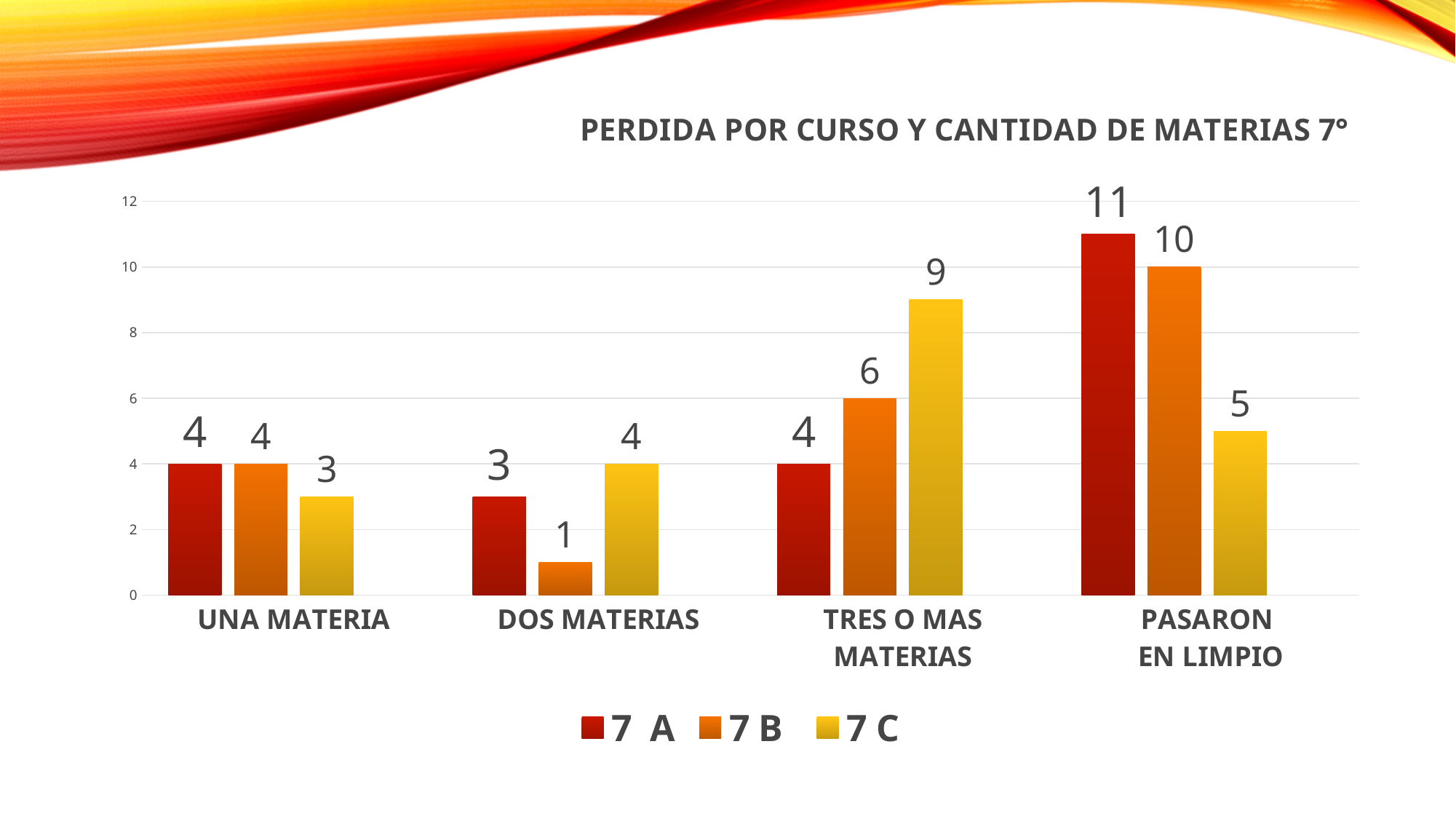
What is the value for 7 A in the UNA MATERIA category? 4 What is the value for 7 B in the DOS MATERIAS category? 1 Which is larger in the TRES O MAS MATERIAS category, 7 A or 7 B? 7 B What kind of chart is shown on the slide? Bar chart Which series has the lowest value in the DOS MATERIAS category? 7 B How many categories are shown on the x axis? 4 What is the value for 7 B in the PASARON EN LIMPIO category? 10 Which series has the highest value in the PASARON EN LIMPIO category? 7 A What is the title of the chart? PERDIDA POR CURSO Y CANTIDAD DE MATERIAS 7° What is the value for 7 C in the TRES O MAS MATERIAS category? 9 What is the difference between the 7 A and 7 C values in the PASARON EN LIMPIO category? 6 How many series does the legend list? 3